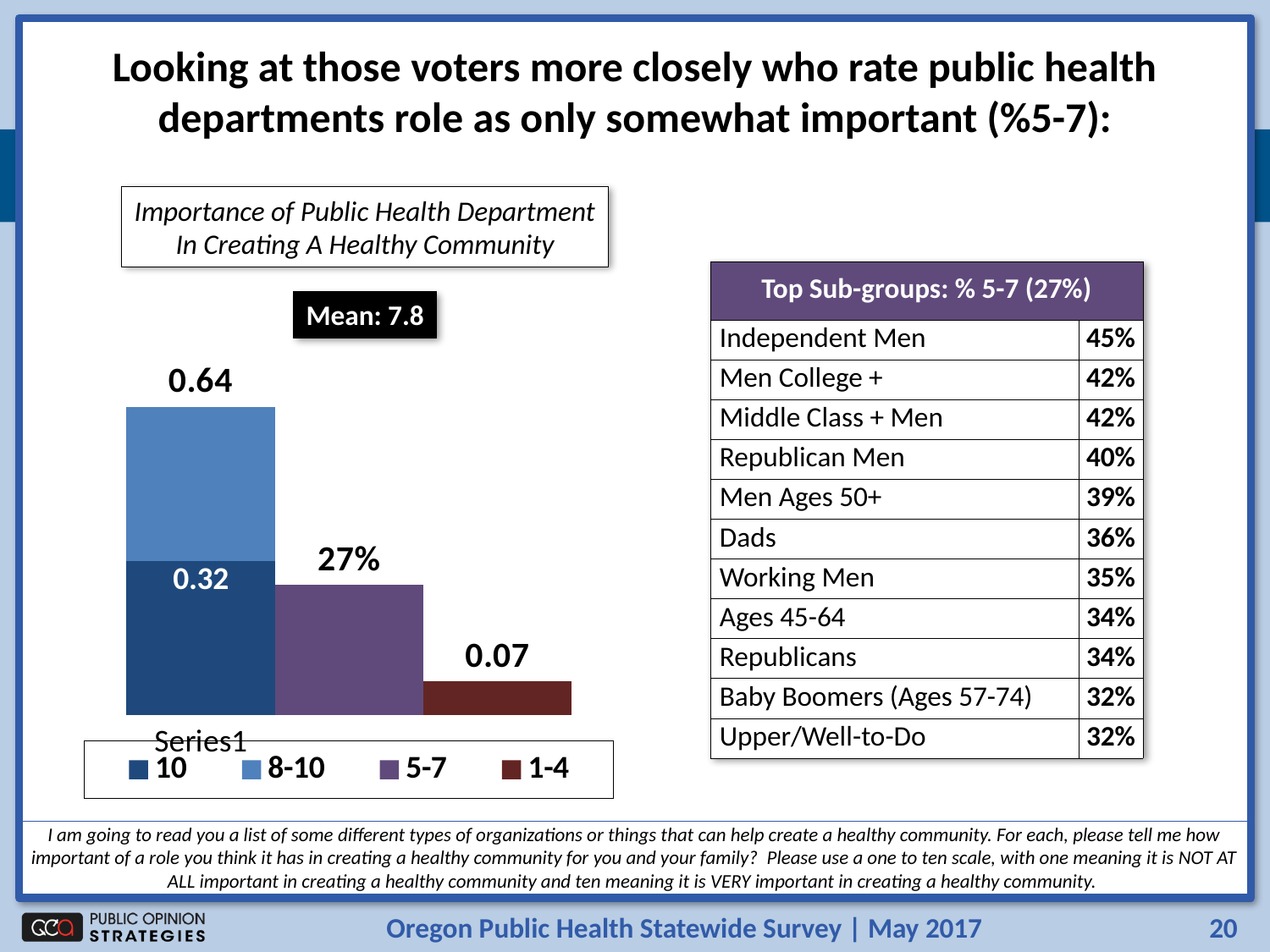
What value is shown for the 1-4 series in the chart? 0.07 What is the difference between the 8-10 value and the 10 value? 0.32 Which series has the highest value in the chart? 8-10 Which series has the lowest value in the chart? 1-4 What value is shown for the 8-10 series in the chart? 0.64 What value is shown for the 10 series in the chart? 0.32 Which is larger, the value for 8-10 or the value for 5-7? 8-10 How many series does the chart legend list? 4 What value is shown for the 5-7 series in the chart? 27% What is the difference between the 8-10 value and the 1-4 value? 0.57 What mean value is shown above the chart? 7.8 What kind of chart is shown on the slide? Bar chart